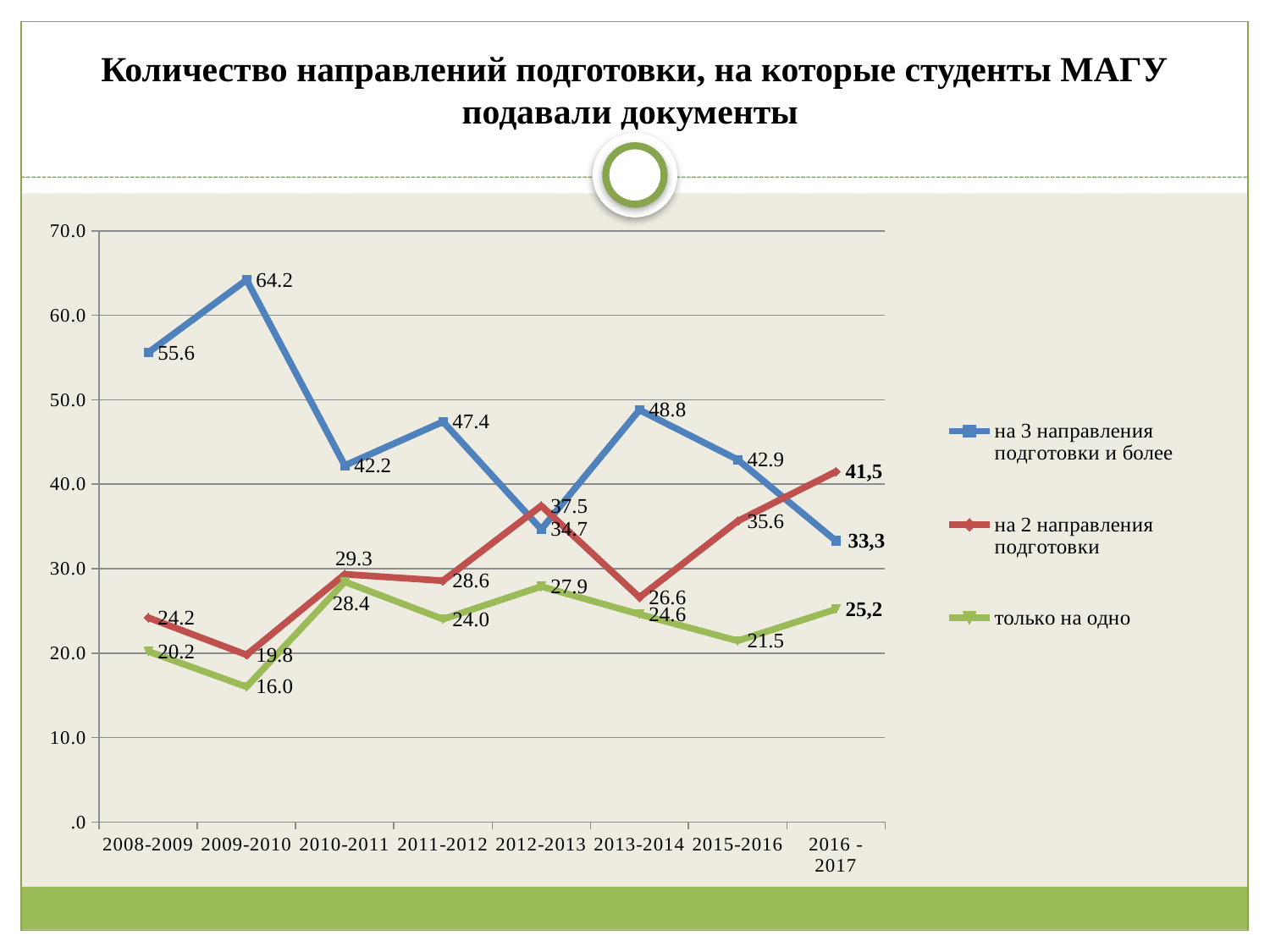
How many series does the legend list? 3 What is the value for 'на 2 направления подготовки' in 2016-2017? 41,5 What is the value for 'только на одно' in 2009-2010? 16.0 In 2012-2013, which series has the larger value: 'на 2 направления подготовки' or 'на 3 направления подготовки и более'? на 2 направления подготовки What kind of chart is shown on the slide? line chart Does the series 'на 3 направления подготовки и более' rise or fall from 2013-2014 to 2016-2017? fall How many periods are shown on the x axis? 8 In which period does the series 'на 3 направления подготовки и более' reach its highest value? 2009-2010 What is the difference between 'на 3 направления подготовки и более' and 'на 2 направления подготовки' in 2008-2009? 31.4 What is the value for 'на 3 направления подготовки и более' in 2009-2010? 64.2 What is the value for 'на 2 направления подготовки' in 2015-2016? 35.6 In which period does the series 'только на одно' have its lowest value? 2009-2010